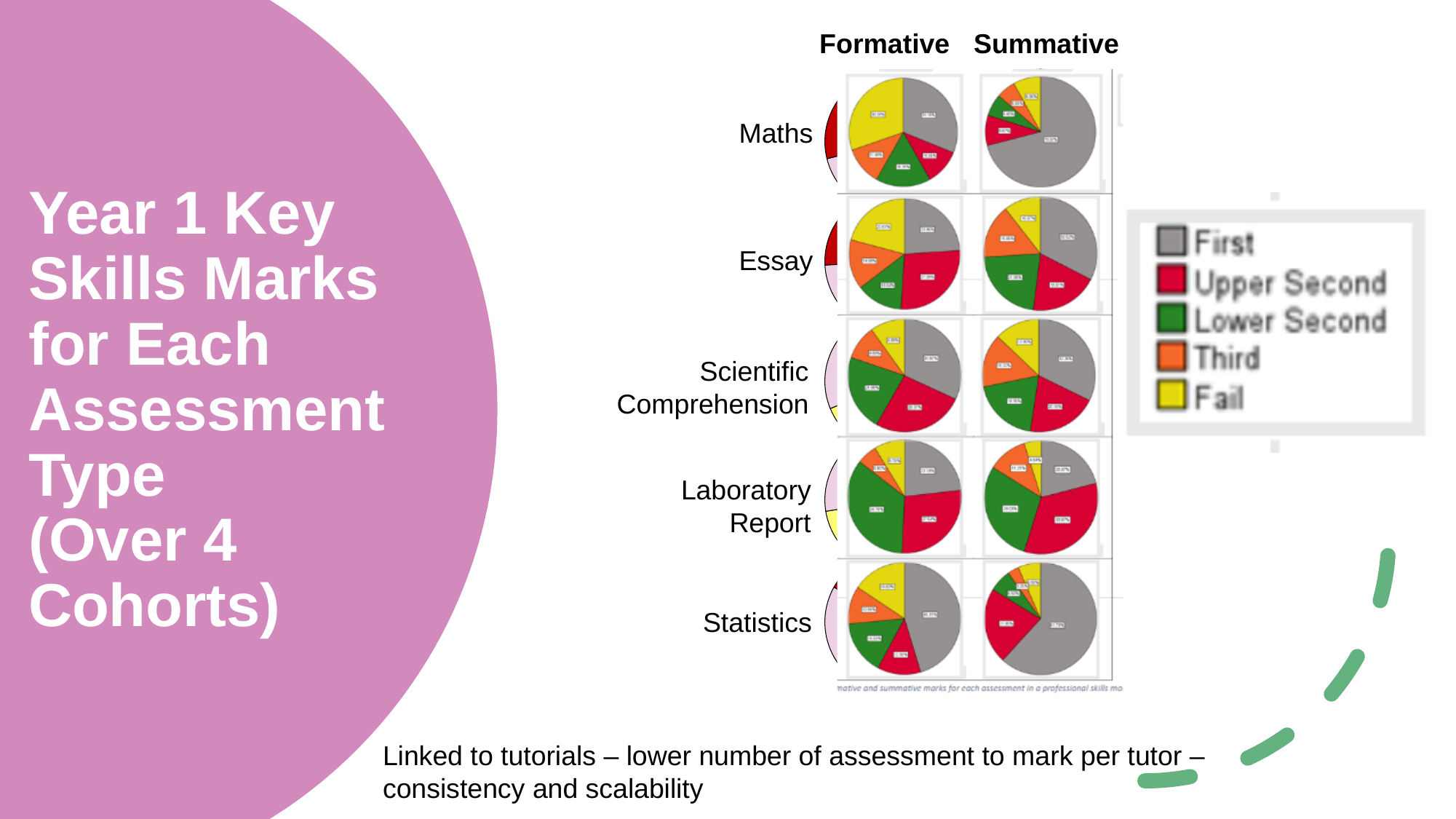
In the Statistics Summative pie chart, which mark category has the largest slice? First What colour represents the Fail category in the legend? Yellow In the Laboratory Report Summative pie chart, which mark category has the smallest slice? Fail How many mark categories does the legend list? 5 In the Scientific Comprehension Formative pie chart, which mark category has the smallest slice? Fail In the Laboratory Report Summative pie chart, which mark category has the largest slice? Upper Second Is the First slice larger in the Maths Formative pie chart or the Maths Summative pie chart? Maths Summative How many pie charts are shown on the slide? 10 In the Maths Summative pie chart, which mark category has the largest slice? First How many assessment types are listed down the left of the pie charts? 5 Is the Fail slice larger in the Maths Formative pie chart or the Maths Summative pie chart? Maths Formative What kind of chart is used to show the marks for each assessment type? Pie chart